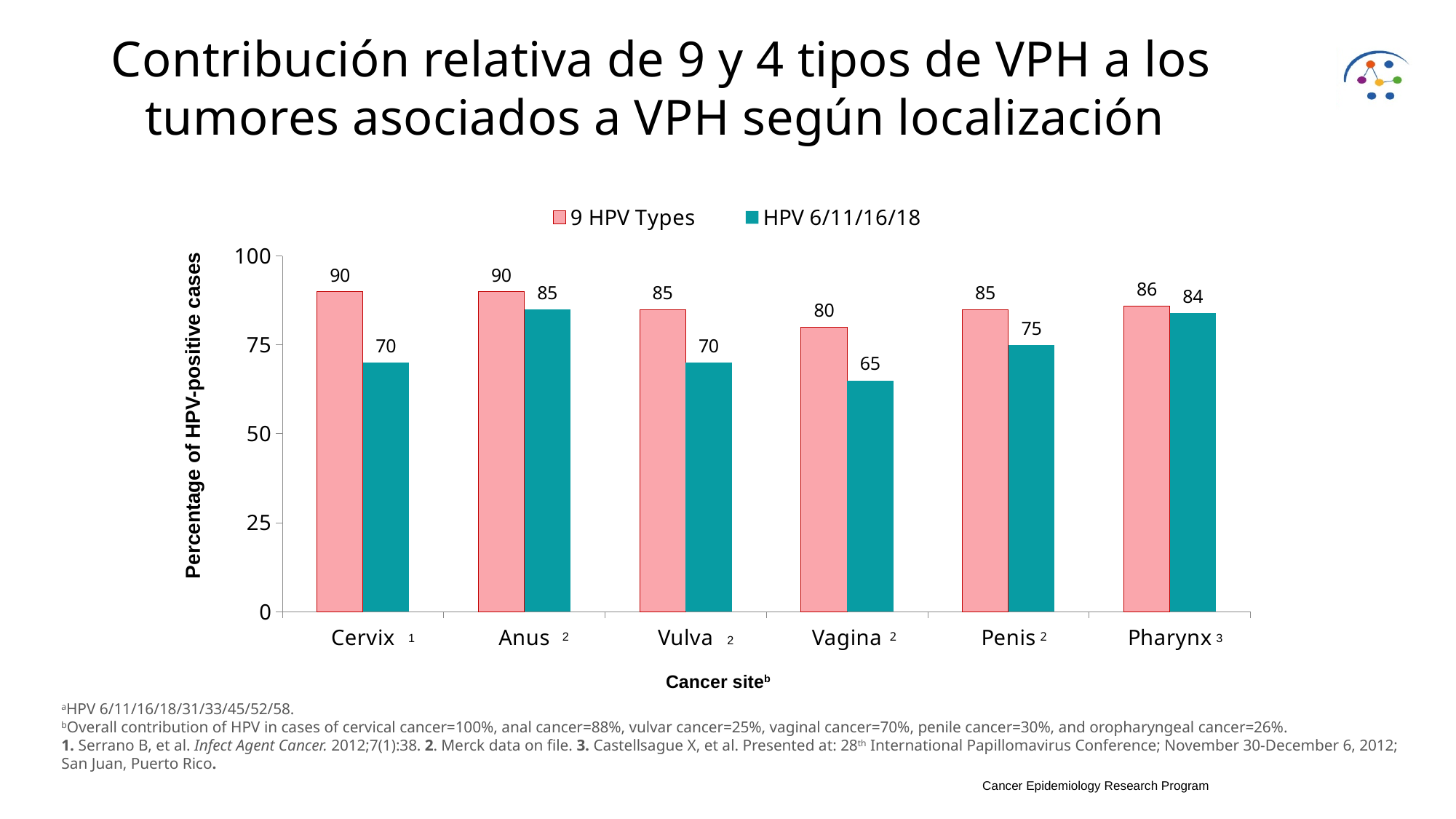
Which is larger: the HPV 6/11/16/18 value for Anus or the HPV 6/11/16/18 value for Vulva? Anus What is the label of the y axis? Percentage of HPV-positive cases What is the difference between the 9 HPV Types and HPV 6/11/16/18 values at the Cervix cancer site? 20 What is the difference between the 9 HPV Types and HPV 6/11/16/18 values at the Penis cancer site? 10 Which cancer site has the lowest value for 9 HPV Types? Vagina How many series does the legend list? 2 What is the value for HPV 6/11/16/18 at the Pharynx cancer site? 84 What kind of chart is shown on the slide? Bar chart What is the value for 9 HPV Types at the Cervix cancer site? 90 Which cancer site has the lowest value for HPV 6/11/16/18? Vagina How many cancer sites are shown on the x axis? 6 What is the value for HPV 6/11/16/18 at the Vagina cancer site? 65